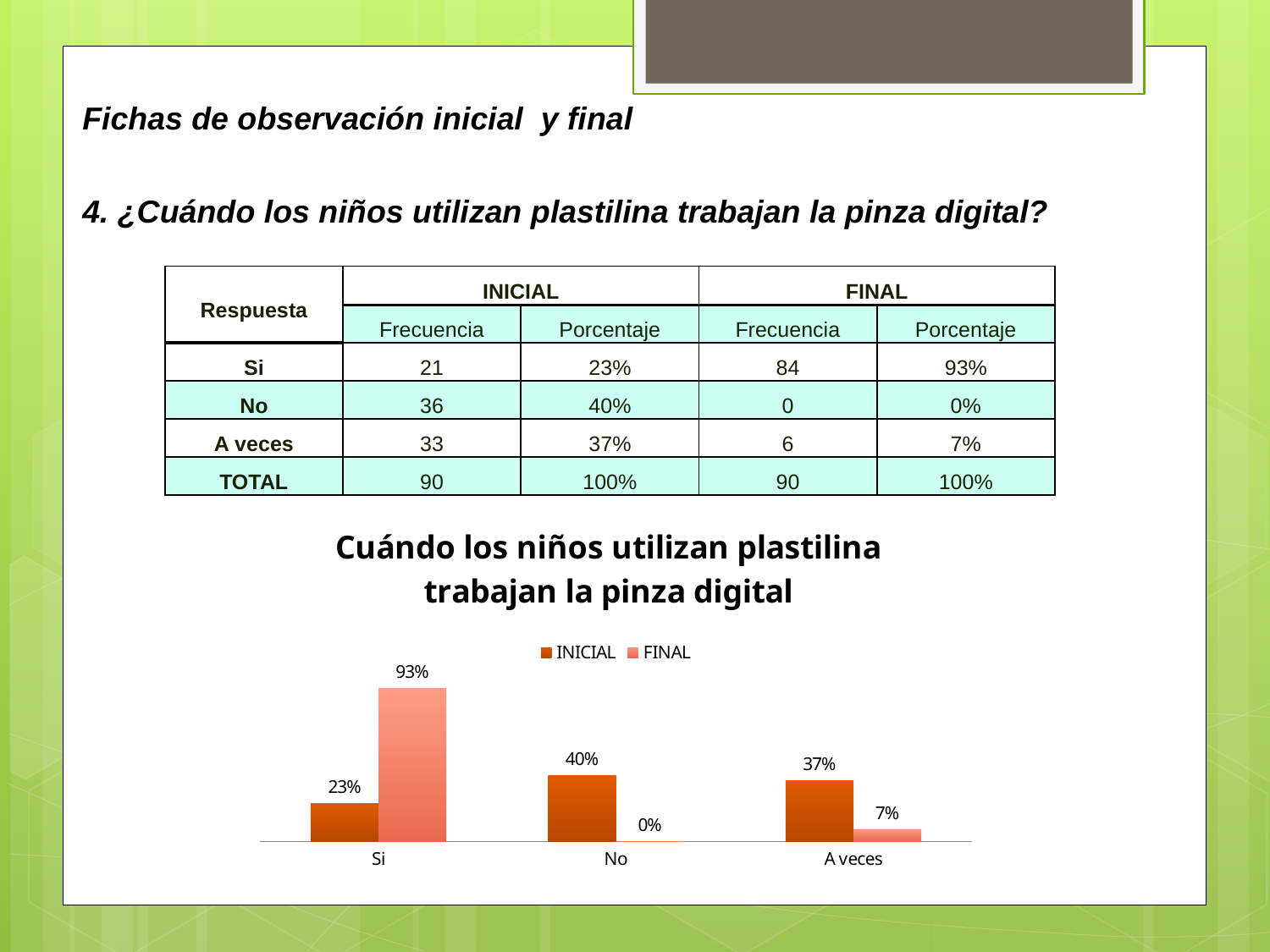
Which category has the highest INICIAL value in the chart? No What is the FINAL value for Si in the chart? 93% How many series does the chart legend list? 2 How many categories are shown on the x axis of the chart? 3 What is the title of the chart? Cuándo los niños utilizan plastilina trabajan la pinza digital What is the FINAL value for A veces in the chart? 7% Which category has the lowest FINAL value in the chart? No What kind of chart is shown on the slide? Bar chart What is the INICIAL value for Si in the chart? 23% What is the INICIAL value for No in the chart? 40% For A veces, which series has the larger value in the chart, INICIAL or FINAL? INICIAL What is the difference between the FINAL and INICIAL values for Si in the chart? 70%